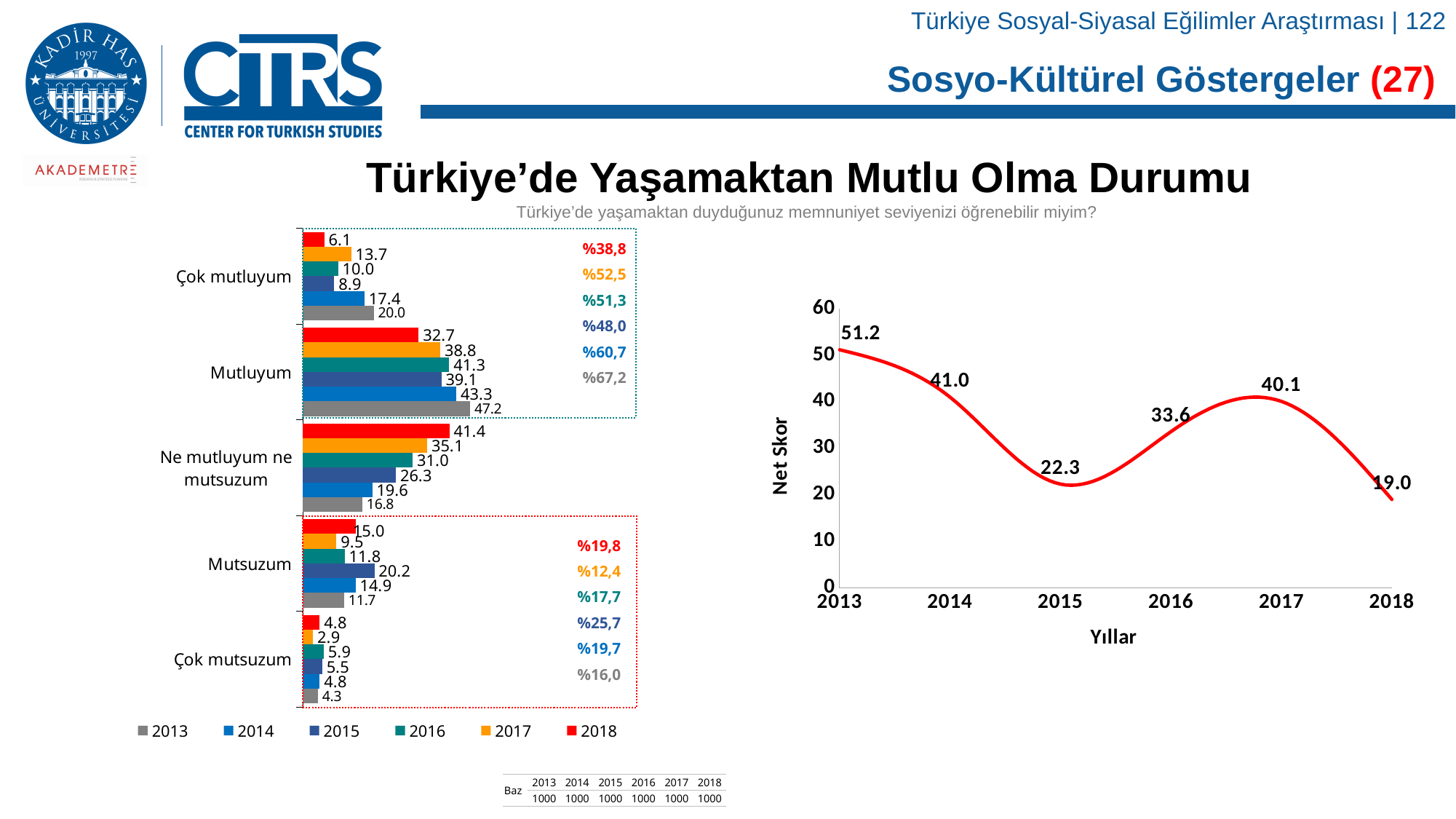
In the line chart on the right, what is the difference between the Net Skor for 2017 and 2016? 6.5 In the bar chart on the left, which is larger for 'Mutsuzum': the 2015 value or the 2017 value? 2015 In the bar chart on the left, what is the difference between the 2013 and 2018 values for 'Mutluyum'? 14.5 In the line chart on the right, what is the Net Skor value for 2013? 51.2 In the bar chart on the left, which year has the highest value for 'Ne mutluyum ne mutsuzum'? 2018 In the bar chart on the left, how many series does the legend list? 6 In the line chart on the right, how many data points are plotted? 6 In the line chart on the right, which year has the lowest Net Skor? 2018 In the bar chart on the left, what is the 2018 value for 'Mutluyum'? 32.7 In the line chart on the right, does the Net Skor rise or fall from 2013 to 2015? fall In the bar chart on the left, what is the 2013 value for 'Çok mutluyum'? 20.0 What type of chart is shown on the left of the slide? bar chart